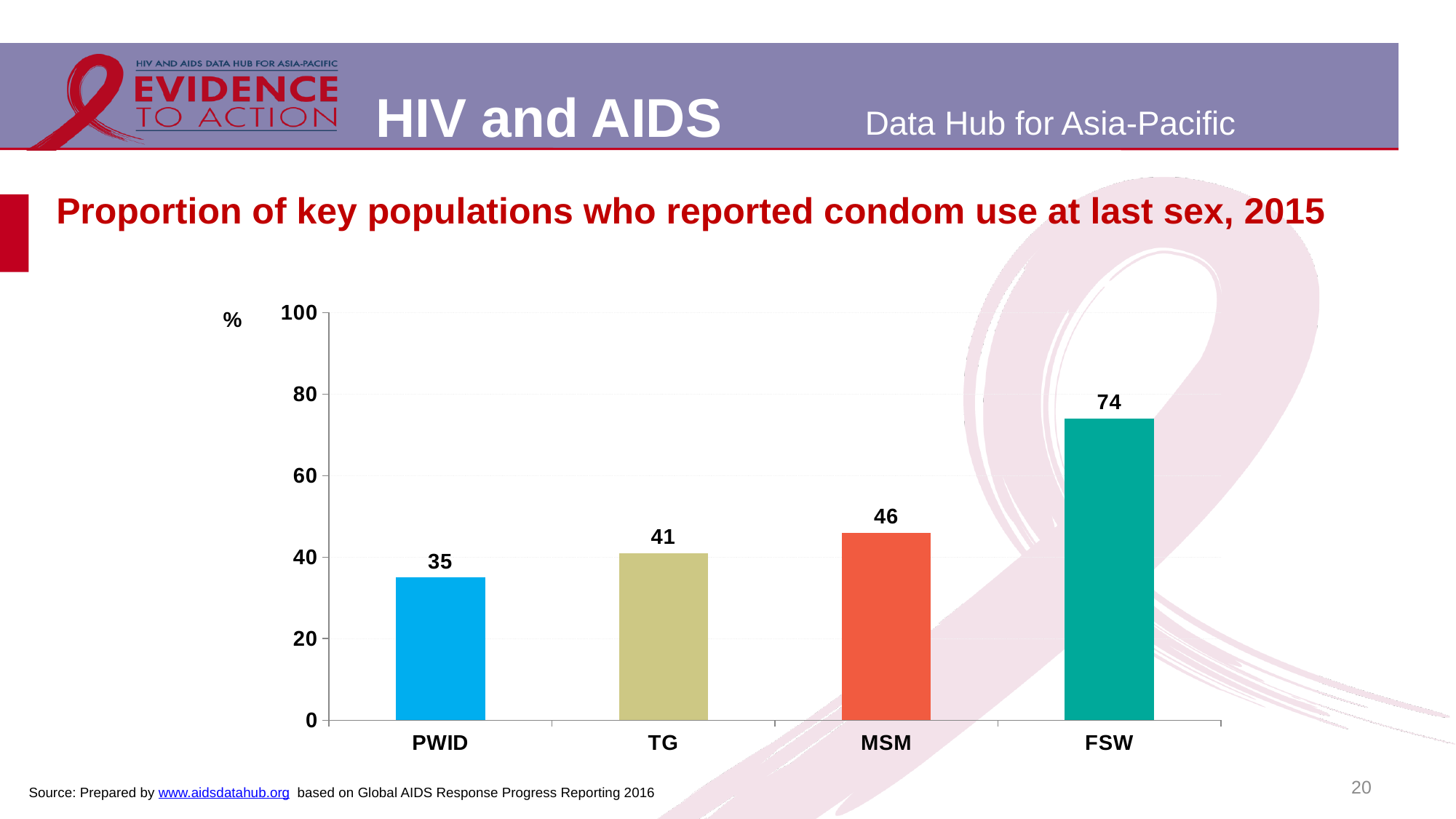
Do the values rise or fall from PWID to FSW along the x axis? Rise What is the difference between the values for FSW and PWID? 39 What is the value for FSW? 74 What kind of chart is shown on the slide? Bar chart What is the value for PWID? 35 Is the value for FSW greater or less than 60? greater What is the difference between the values for MSM and TG? 5 How many key populations are shown on the chart? 4 What is the value for MSM? 46 Which is larger, the value for TG or the value for MSM? MSM Which key population has the lowest reported condom use at last sex? PWID Which key population has the highest reported condom use at last sex? FSW